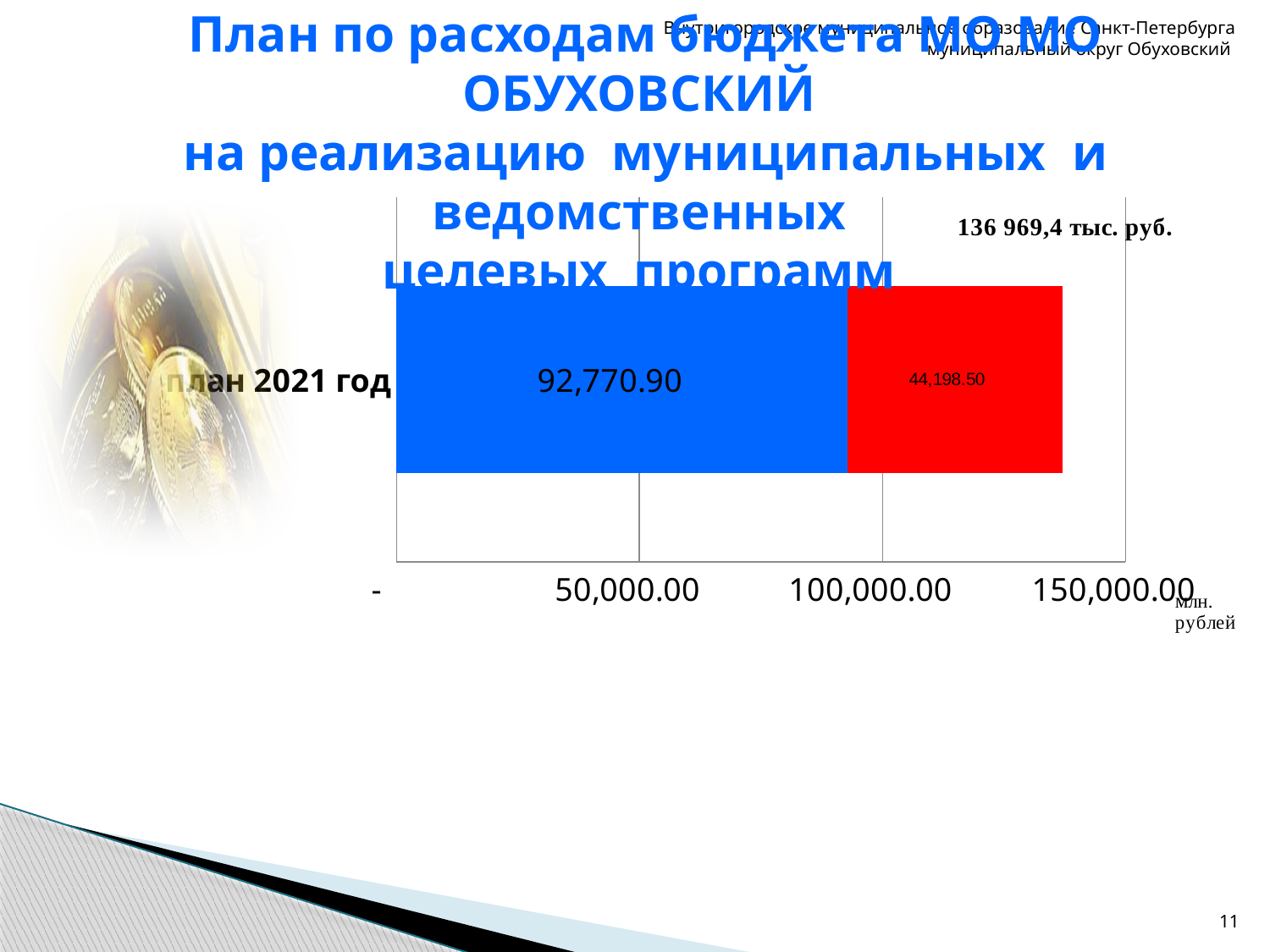
What total is printed above the stacked bar for план 2021 год? 136 969,4 тыс. руб. What kind of chart is shown on the slide? stacked bar chart What is the difference between the blue segment (92,770.90) and the red segment (44,198.50) of the план 2021 год bar? 48,572.40 Which segment of the план 2021 год bar is larger, the blue one or the red one? the blue one What is the highest tick value shown on the horizontal axis of the chart? 150,000.00 Is the blue segment of the план 2021 год bar greater or less than 100,000.00? less What is the label of the single category on the chart's vertical axis? план 2021 год Is the total length of the план 2021 год bar greater or less than 100,000.00? greater What is the value of the blue segment of the bar for план 2021 год? 92,770.90 What is the value of the red segment of the bar for план 2021 год? 44,198.50 How many categories are plotted on the chart? 1